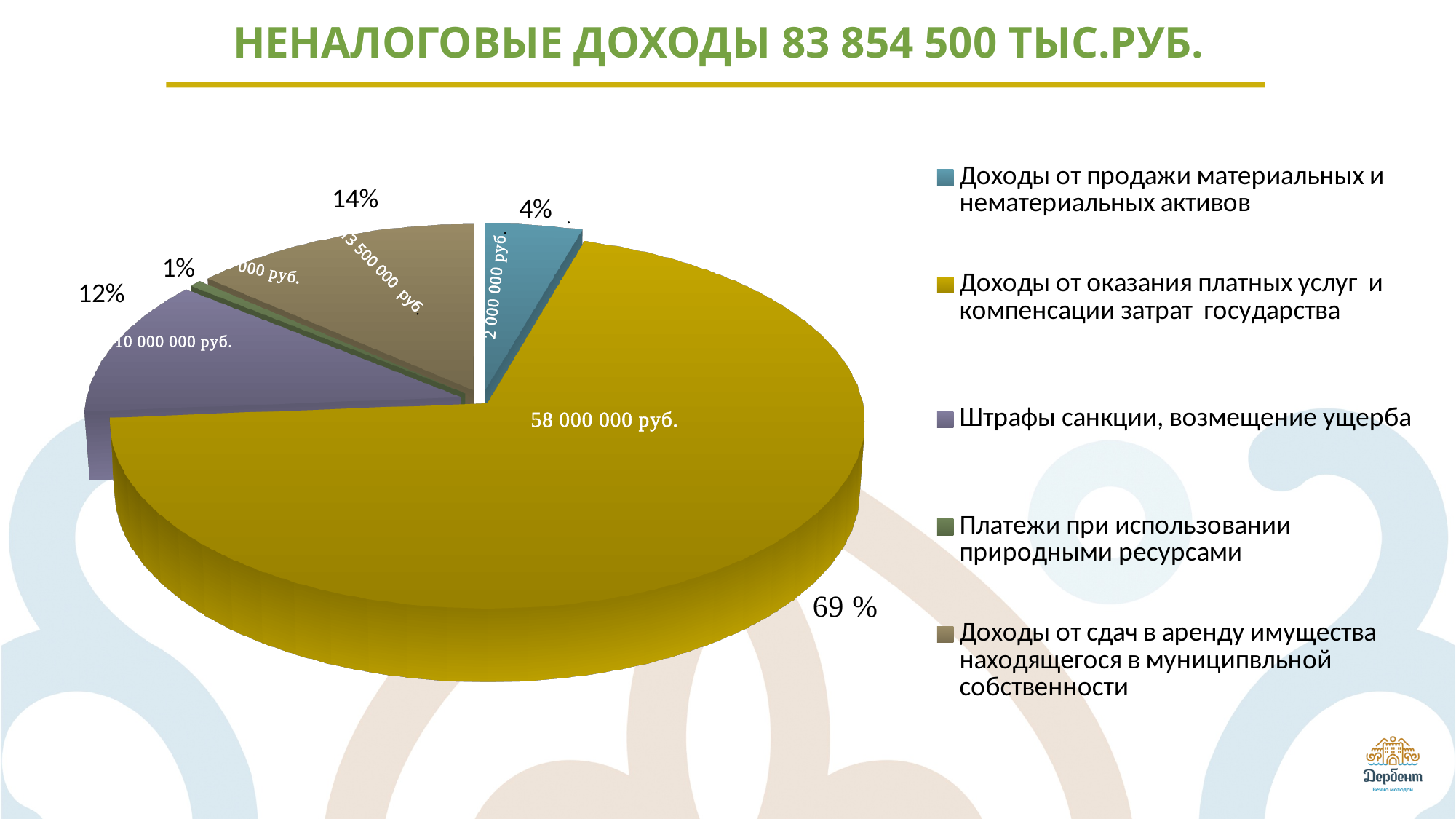
What share of the pie is labelled for Доходы от оказания платных услуг и компенсации затрат государства? 69 % Which category has the largest share of the pie? Доходы от оказания платных услуг и компенсации затрат государства What kind of chart is shown on the slide? pie chart Which slice is larger: Штрафы санкции, возмещение ущерба or Доходы от продажи материальных и нематериальных активов? Штрафы санкции, возмещение ущерба How many slices does the pie chart have? 5 What is the title of the slide above the chart? НЕНАЛОГОВЫЕ ДОХОДЫ 83 854 500 ТЫС.РУБ. What share of the pie is labelled for Штрафы санкции, возмещение ущерба? 12% How many entries does the legend list? 5 What share of the pie is labelled for Доходы от продажи материальных и нематериальных активов? 4% What value is printed on the slice for Доходы от оказания платных услуг и компенсации затрат государства? 58 000 000 руб. Which category has the smallest share of the pie? Платежи при использовании природными ресурсами What value is printed on the slice for Штрафы санкции, возмещение ущерба? 10 000 000 руб.